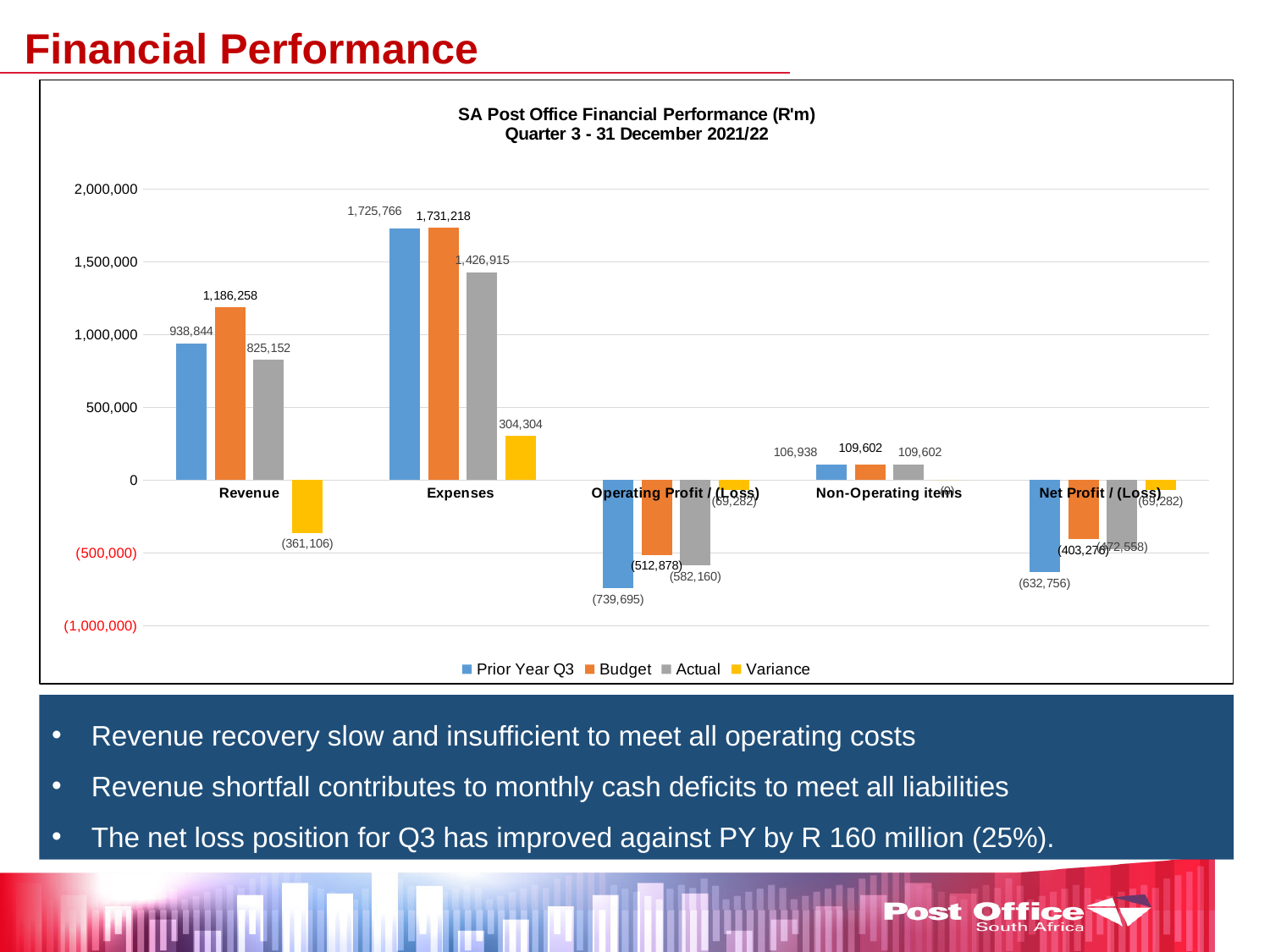
Which category has the highest Budget value? Expenses What is the Prior Year Q3 value for Non-Operating items? 106,938 What is the difference between the Budget and Actual values for Revenue? 361,106 What is the Budget value for Expenses? 1,731,218 What is the Variance value for Revenue? (361,106) What is the Actual value for Revenue? 825,152 How many series does the legend list? 4 How many categories are shown on the x axis? 5 Which is larger for Expenses, the Prior Year Q3 value or the Budget value? Budget Is the Actual value for Expenses greater or less than 1,000,000? greater What is the Prior Year Q3 value for Operating Profit / (Loss)? (739,695) What kind of chart is shown on the slide? Bar chart